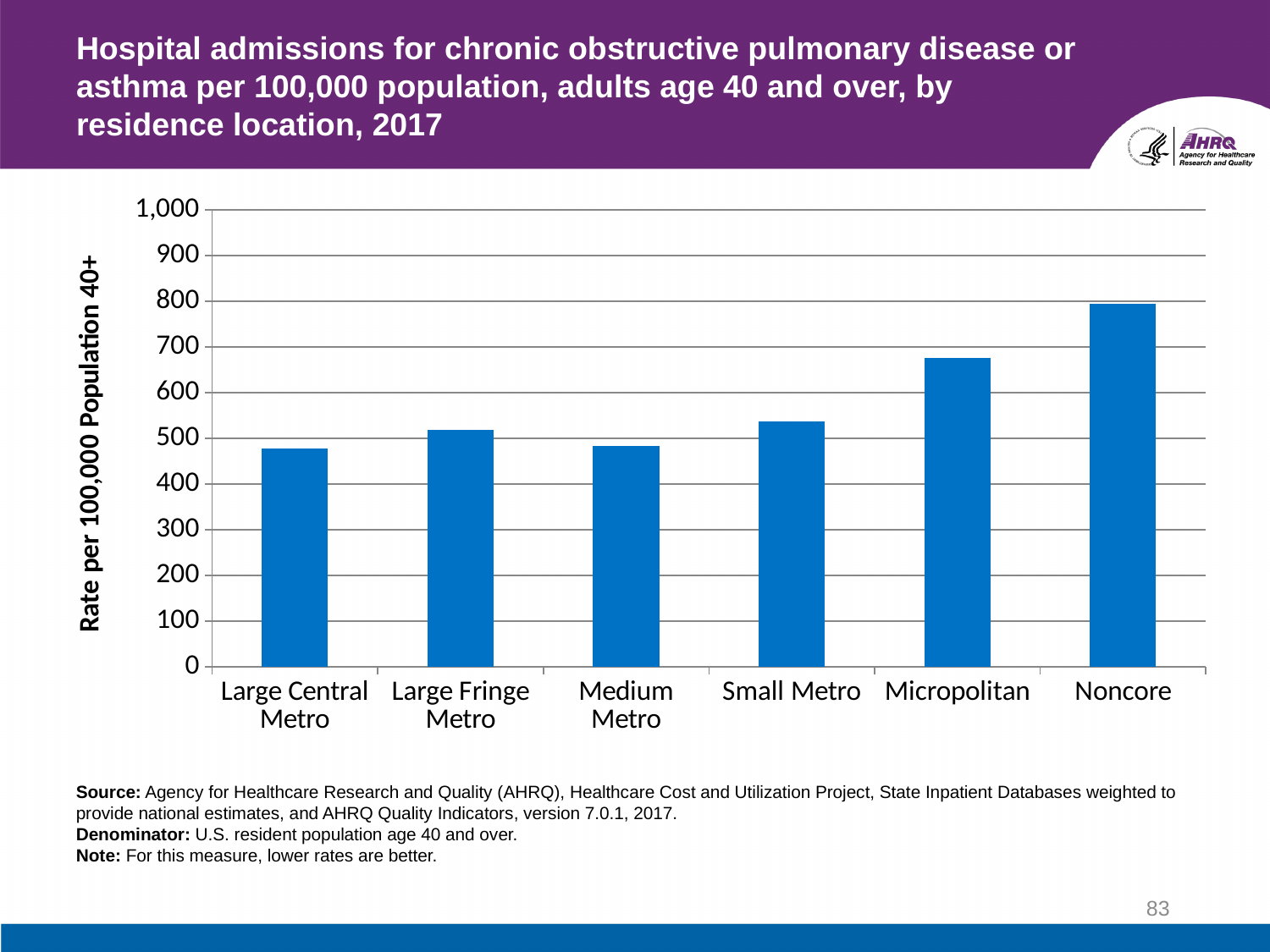
How many residence location categories are shown on the x axis? 6 What is the label of the y axis? Rate per 100,000 Population 40+ Which has a higher admission rate, Noncore or Micropolitan? Noncore Is the value for Noncore greater or less than 700? greater Is the value for Medium Metro greater or less than 600? less Is the value for Large Central Metro greater or less than 500? less What is the maximum value shown on the y axis? 1,000 What kind of chart is shown on the slide? bar chart Which has a higher admission rate, Small Metro or Large Central Metro? Small Metro Which residence location has the highest hospital admission rate? Noncore